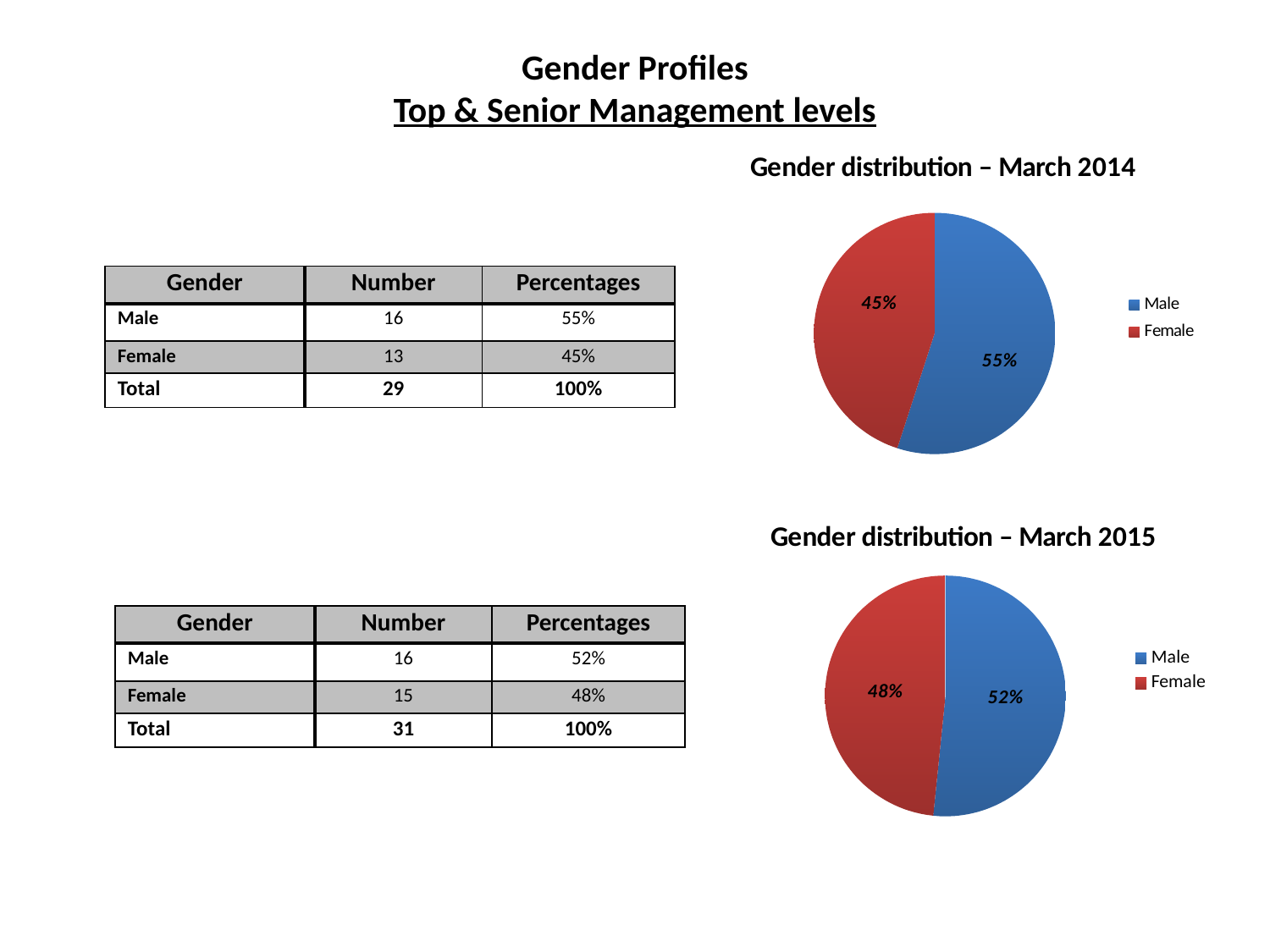
In the 'Gender distribution – March 2015' chart, which category has the smallest slice? Female In the 'Gender distribution – March 2015' chart, what share of the pie is Male? 52% In the 'Gender distribution – March 2015' chart, what is the difference in percentage points between the Male and Female slices? 4 In the 'Gender distribution – March 2014' chart, what share of the pie is Male? 55% In the 'Gender distribution – March 2014' chart, which category has the largest slice? Male What kind of chart is 'Gender distribution – March 2014'? Pie chart In the 'Gender distribution – March 2014' chart, what share of the pie is Female? 45% How many entries does the legend of the 'Gender distribution – March 2014' chart list? 2 In the 'Gender distribution – March 2015' chart, what colour is the Female slice? Red How many slices does the 'Gender distribution – March 2015' pie chart have? 2 In the 'Gender distribution – March 2014' chart, what is the difference in percentage points between the Male and Female slices? 10